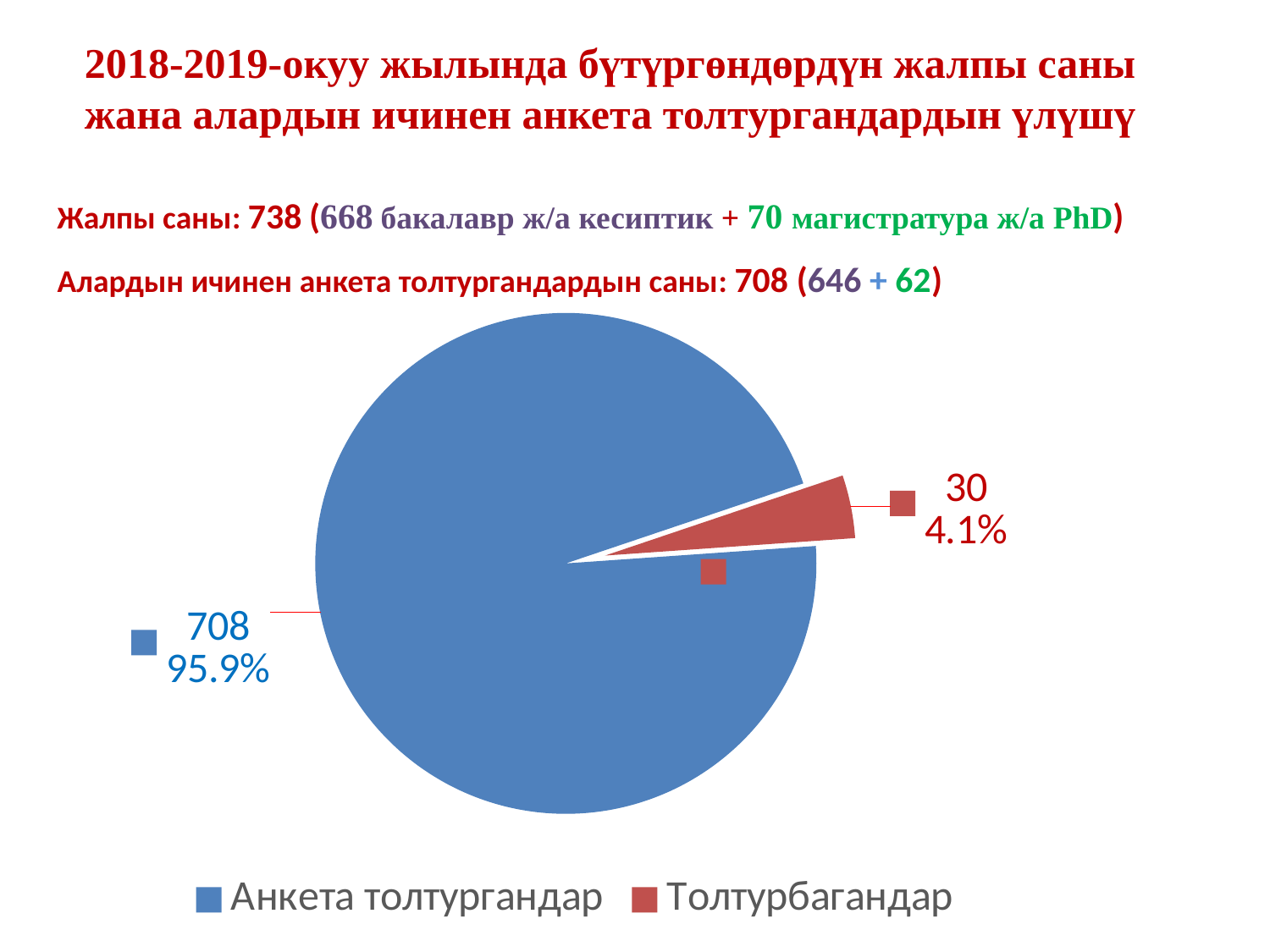
What is the difference between the values for Анкета толтургандар and Толтурбагандар? 678 What is the total of the two slices in the pie chart? 738 What share of the pie does Толтурбагандар take? 4.1% How many slices does the pie chart have? 2 Which is larger, Анкета толтургандар or Толтурбагандар? Анкета толтургандар What kind of chart is shown on the slide? pie chart What share of the pie does Анкета толтургандар take? 95.9% Which slice is the smallest? Толтурбагандар What is the value for Анкета толтургандар? 708 What is the value for Толтурбагандар? 30 Which slice is the largest? Анкета толтургандар What colour is the Толтурбагандар slice? red